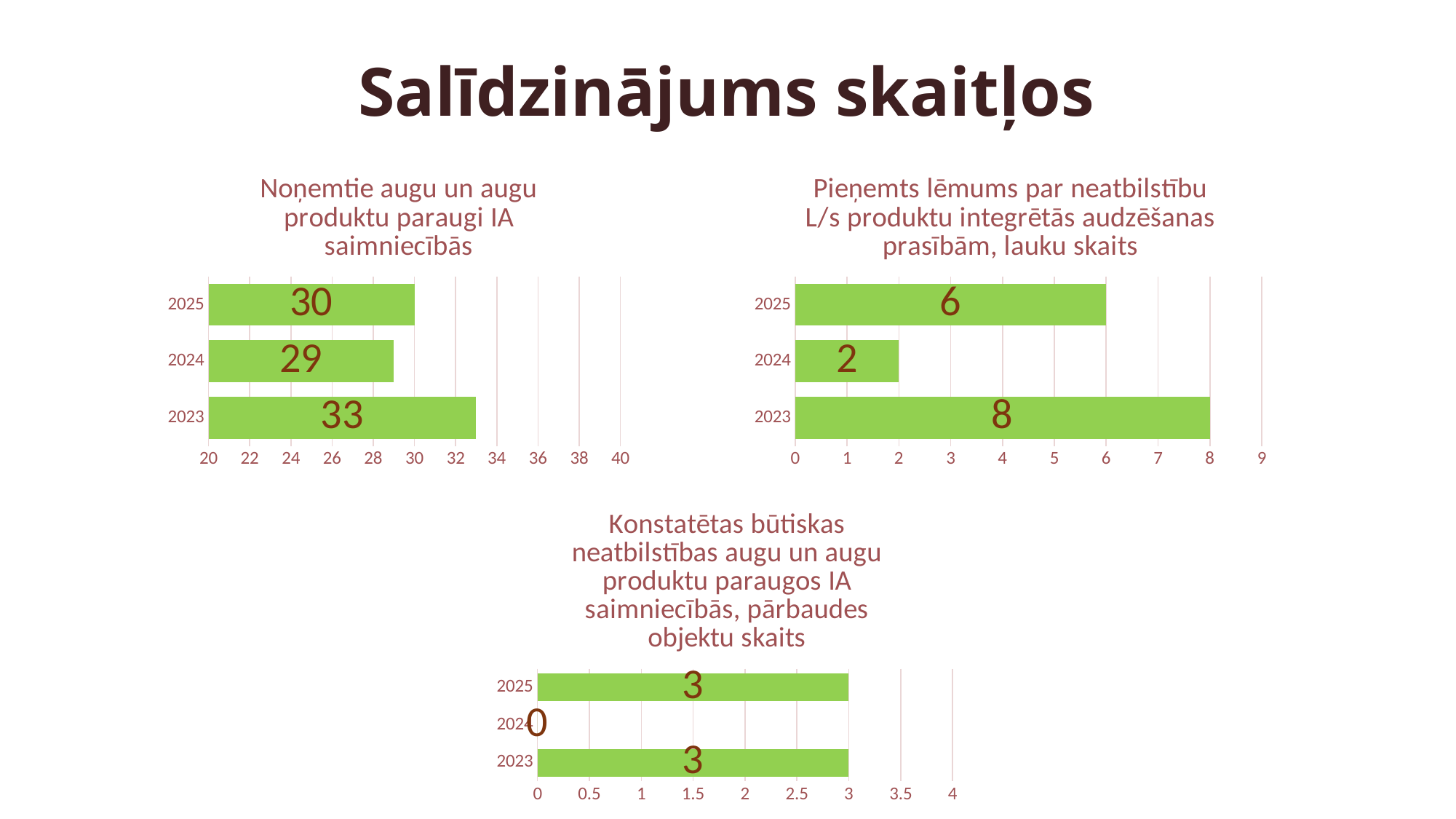
What type of chart is the chart titled "Pieņemts lēmums par neatbilstību L/s produktu integrētās audzēšanas prasībām, lauku skaits"? Bar chart How many years are shown in the chart titled "Noņemtie augu un augu produktu paraugi IA saimniecībās"? 3 In the chart titled "Pieņemts lēmums par neatbilstību L/s produktu integrētās audzēšanas prasībām, lauku skaits", is the value for 2025 larger or the value for 2023? 2023 In the chart titled "Noņemtie augu un augu produktu paraugi IA saimniecībās", what is the value for 2025? 30 In the chart titled "Pieņemts lēmums par neatbilstību L/s produktu integrētās audzēšanas prasībām, lauku skaits", what is the difference between the values for 2023 and 2025? 2 In the bottom chart titled "Konstatētas būtiskas neatbilstības augu un augu produktu paraugos IA saimniecībās, pārbaudes objektu skaits", what is the value for 2024? 0 In the chart titled "Pieņemts lēmums par neatbilstību L/s produktu integrētās audzēšanas prasībām, lauku skaits", what is the value for 2024? 2 In the chart titled "Pieņemts lēmums par neatbilstību L/s produktu integrētās audzēšanas prasībām, lauku skaits", which year has the lowest value? 2024 In the bottom chart titled "Konstatētas būtiskas neatbilstības augu un augu produktu paraugos IA saimniecībās, pārbaudes objektu skaits", what is the value for 2025? 3 In the chart titled "Noņemtie augu un augu produktu paraugi IA saimniecībās", what is the difference between the values for 2023 and 2024? 4 How many charts are shown on the slide? 3 In the chart titled "Noņemtie augu un augu produktu paraugi IA saimniecībās", which year has the highest value? 2023